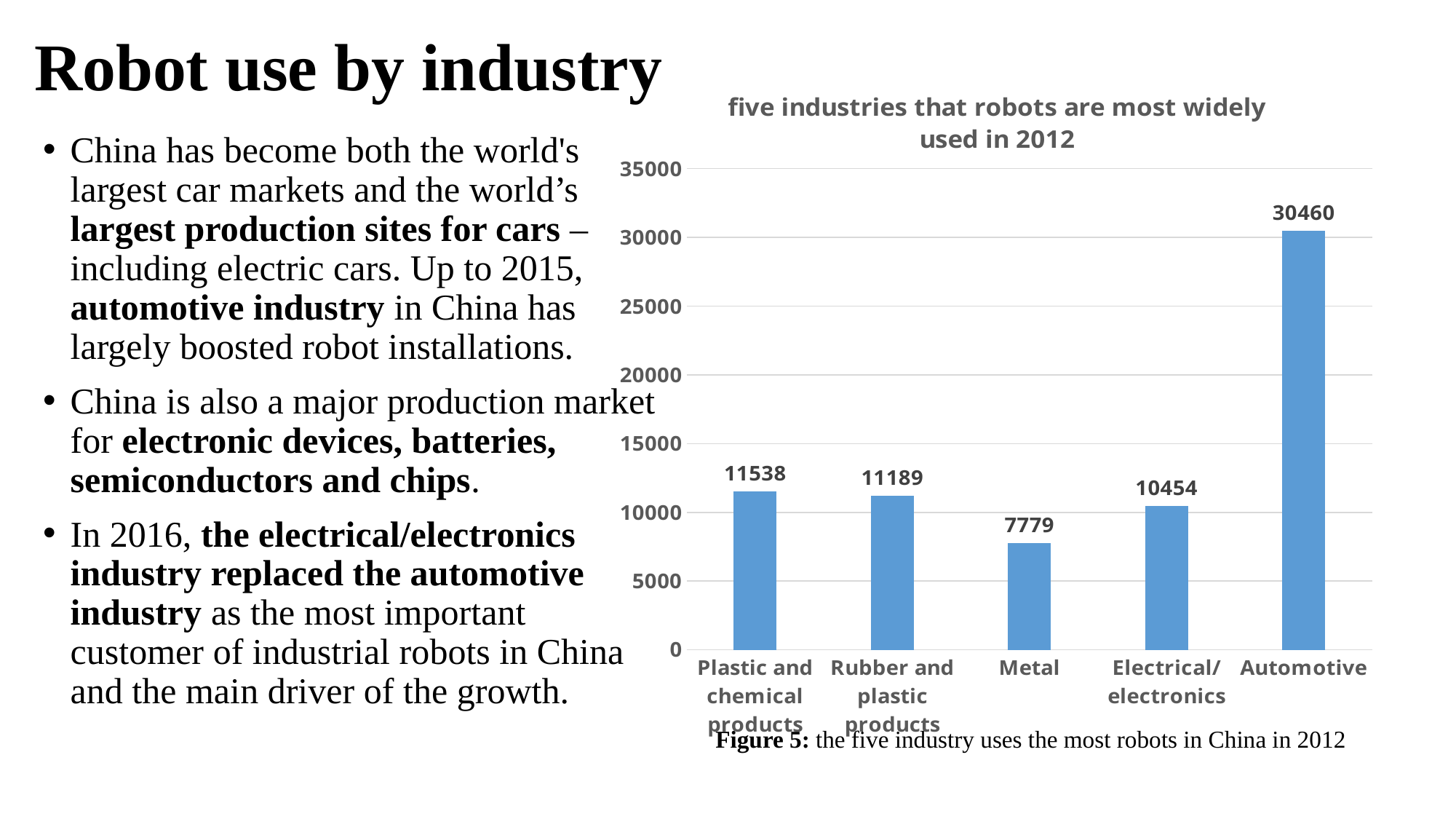
Which is larger, the value for Plastic and chemical products or the value for Electrical/electronics? Plastic and chemical products What kind of chart is shown on the slide? bar chart What is the value for Metal? 7779 How many industries are shown in the chart? 5 What is the difference between the values for Plastic and chemical products and Rubber and plastic products? 349 What is the difference between the values for Automotive and Metal? 22681 What is the value for Rubber and plastic products? 11189 What is the value for Automotive? 30460 Is the value for Metal greater or less than 10000? less Which industry has the highest value? Automotive What is the value for Electrical/electronics? 10454 Which industry has the lowest value? Metal